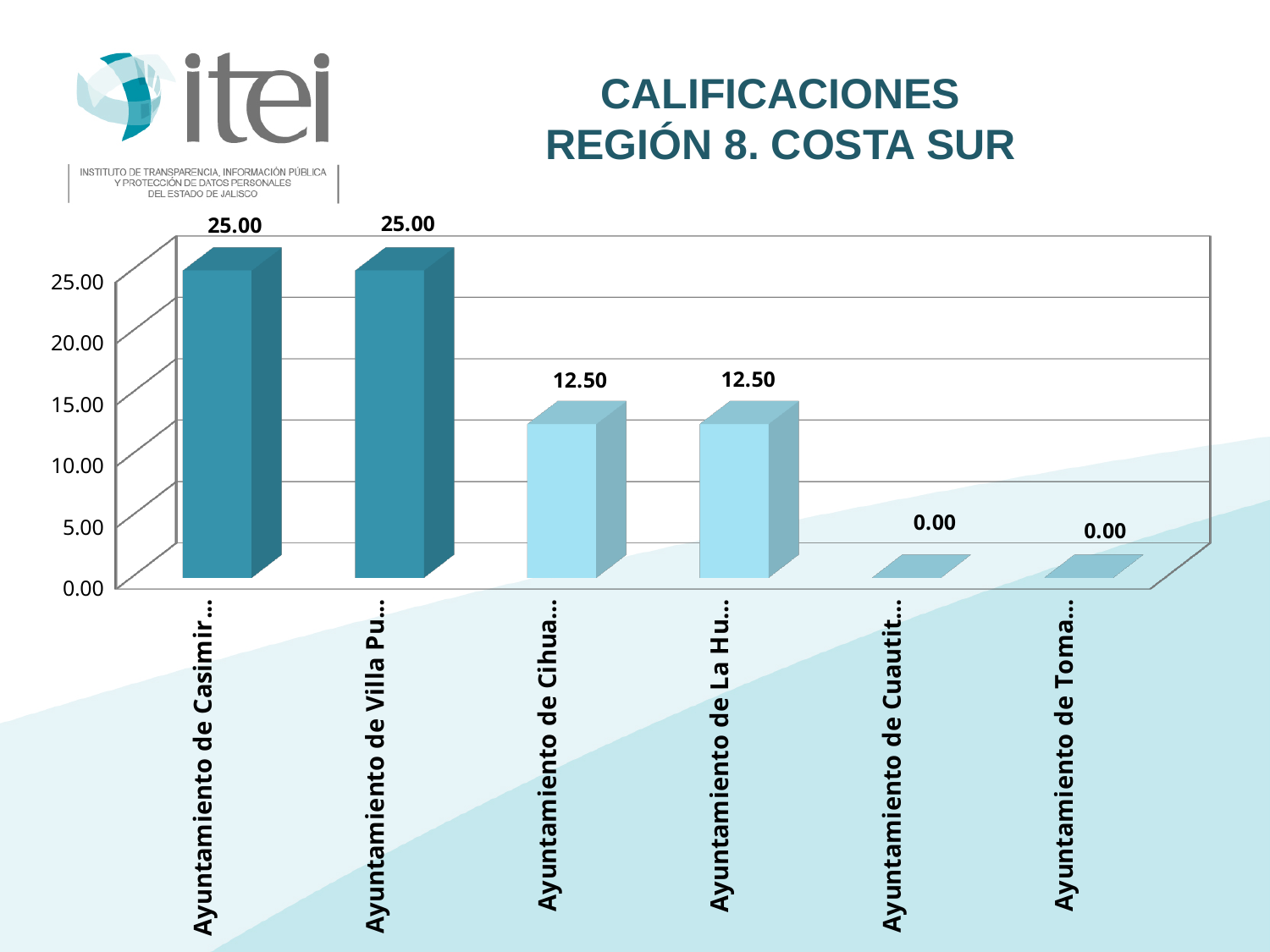
What is the highest value shown in the chart? 25.00 How many bars are shown in the chart? 6 What is the value for the bar labelled "Ayuntamiento de Cuautit…"? 0.00 What is the title of the chart on the slide? CALIFICACIONES REGIÓN 8. COSTA SUR What kind of chart is shown on the slide? bar chart What is the value for the bar labelled "Ayuntamiento de Casimir…"? 25.00 Which has a larger value, "Ayuntamiento de Casimir…" or "Ayuntamiento de La Hu…"? Ayuntamiento de Casimir… What is the lowest value shown in the chart? 0.00 What is the value for the bar labelled "Ayuntamiento de La Hu…"? 12.50 What is the difference between the value for "Ayuntamiento de Villa Pu…" and the value for "Ayuntamiento de Cihua…"? 12.50 Is the value for "Ayuntamiento de Cihua…" greater or less than 15.00? less What is the value for the bar labelled "Ayuntamiento de Cihua…"? 12.50